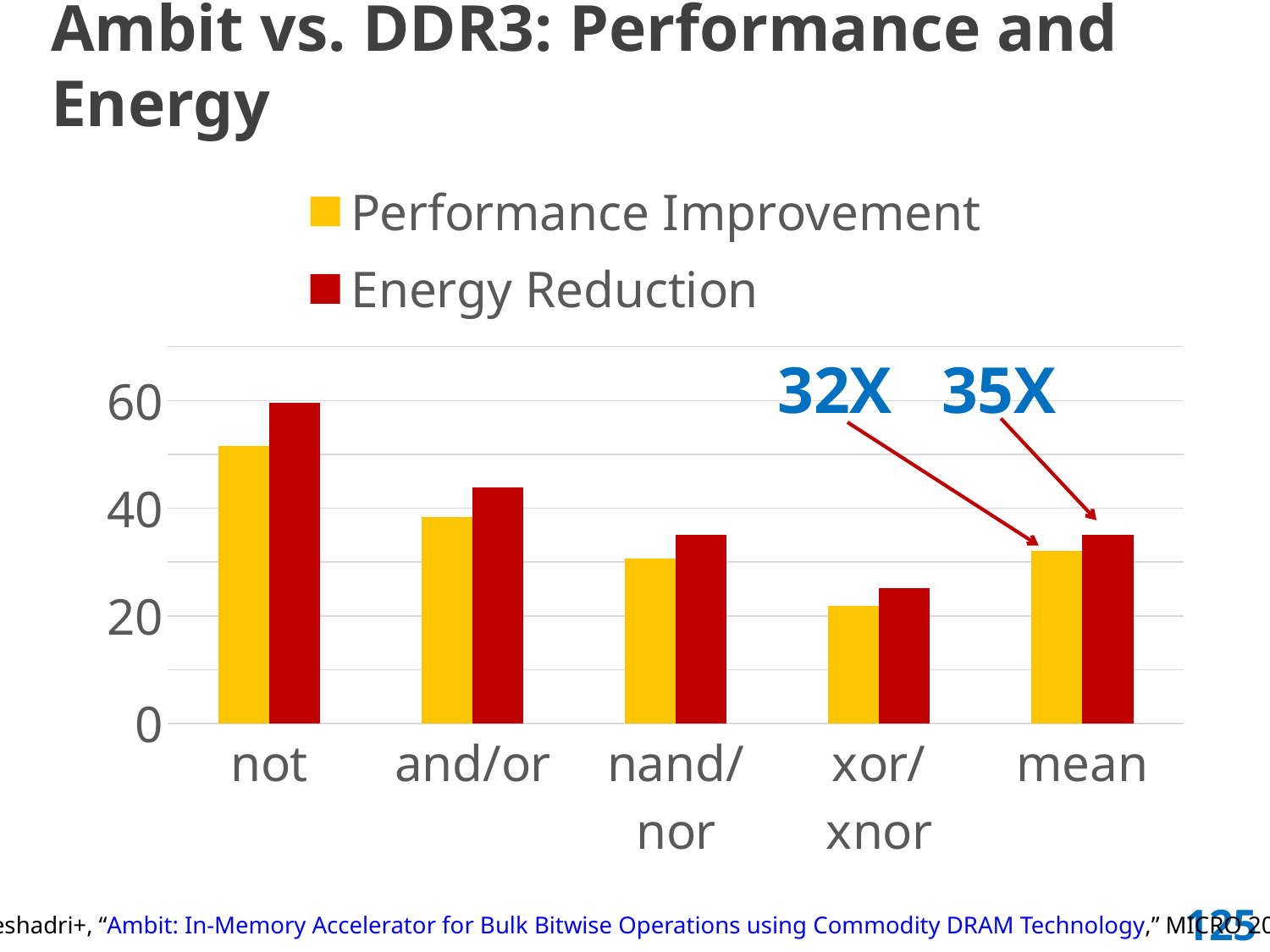
How many series does the legend list? 2 Is the Performance Improvement value for nand/nor greater or less than 40? less What is the difference between the Energy Reduction and Performance Improvement values for the mean category? 3X Which category has the larger Performance Improvement, not or and/or? not What is the Energy Reduction value for the mean category? 35X Is the Energy Reduction value for not greater or less than 40? greater What is the Performance Improvement value for the mean category? 32X Which category has the lowest Performance Improvement? xor/xnor Do the Performance Improvement values rise or fall from not to xor/xnor along the x axis? fall Which category has the highest Energy Reduction? not What kind of chart is shown on the slide? bar chart How many categories are shown on the x axis? 5